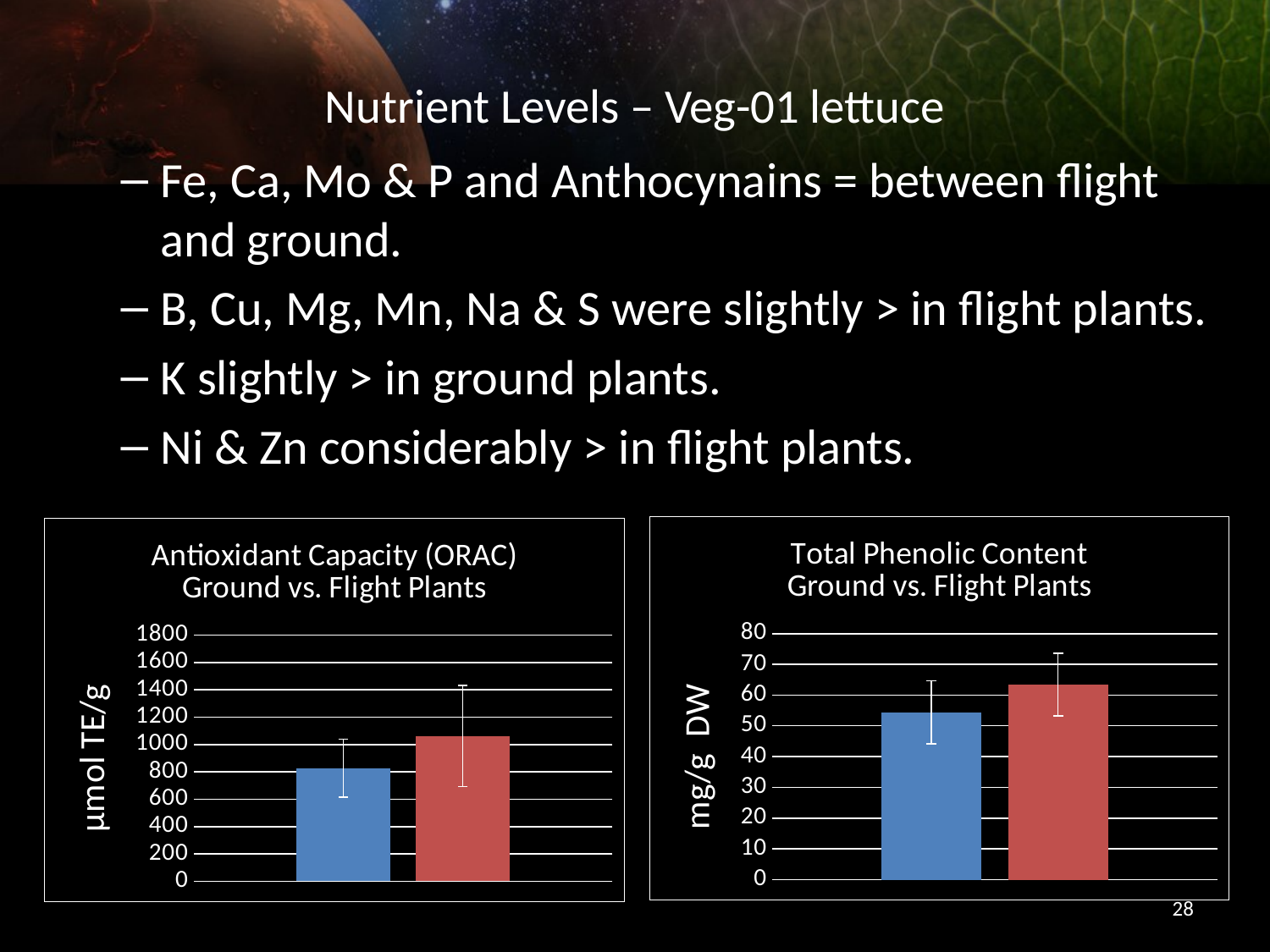
What kind of chart is the Antioxidant Capacity (ORAC) chart on the left? bar chart What is the y-axis label of the Antioxidant Capacity (ORAC) chart? µmol TE/g How many bars are plotted in the Total Phenolic Content chart? 2 What is the y-axis label of the Total Phenolic Content chart? mg/g DW What kind of chart is the Total Phenolic Content chart on the right? bar chart In the Antioxidant Capacity (ORAC) chart, which bar is taller, the blue (left) bar or the red (right) bar? the red (right) bar In the Antioxidant Capacity (ORAC) chart, is the value of the red (right) bar greater or less than 1000? greater How many bars are plotted in the Antioxidant Capacity (ORAC) chart? 2 In the Antioxidant Capacity (ORAC) chart, is the value of the blue (left) bar greater or less than 1000? less In the Total Phenolic Content chart, which bar is taller, the blue (left) bar or the red (right) bar? the red (right) bar In the Total Phenolic Content chart, is the value of the red (right) bar greater or less than 60? greater